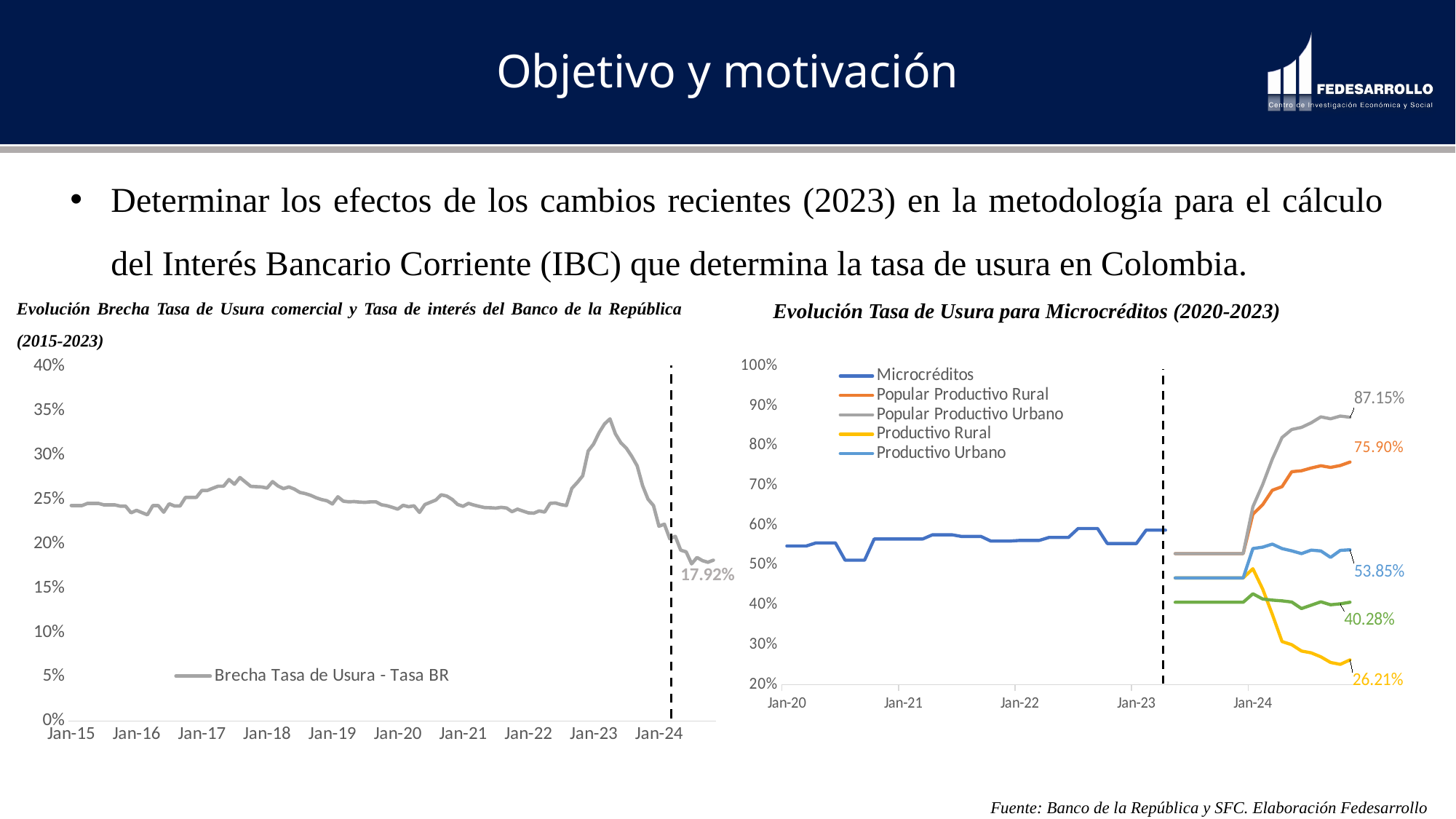
In the left chart on the slide, is the value of 'Brecha Tasa de Usura - Tasa BR' at its peak around Jan-23 greater or less than 30%? greater In the chart 'Evolución Tasa de Usura para Microcréditos (2020-2023)', which series has the lowest final labelled value? Productivo Rural In the chart 'Evolución Tasa de Usura para Microcréditos (2020-2023)', what is the difference between the final labelled values of Popular Productivo Urbano (87.15%) and Popular Productivo Rural (75.90%)? 11.25% In the chart 'Evolución Tasa de Usura para Microcréditos (2020-2023)', what is the final labelled value for Popular Productivo Rural? 75.90% In the left chart on the slide, what is the final labelled value of the series 'Brecha Tasa de Usura - Tasa BR'? 17.92% In the chart 'Evolución Tasa de Usura para Microcréditos (2020-2023)', what is the final labelled value for Productivo Rural? 26.21% In the chart 'Evolución Tasa de Usura para Microcréditos (2020-2023)', which final labelled value is larger: Productivo Urbano or Productivo Rural? Productivo Urbano In the chart 'Evolución Tasa de Usura para Microcréditos (2020-2023)', does the Productivo Rural series rise or fall after Jan-24? Fall What kind of chart is the left chart on the slide? Line chart How many series does the legend list in the chart 'Evolución Tasa de Usura para Microcréditos (2020-2023)'? 5 In the chart 'Evolución Tasa de Usura para Microcréditos (2020-2023)', what is the final labelled value for Popular Productivo Urbano? 87.15% In the chart 'Evolución Tasa de Usura para Microcréditos (2020-2023)', which series has the highest final labelled value? Popular Productivo Urbano